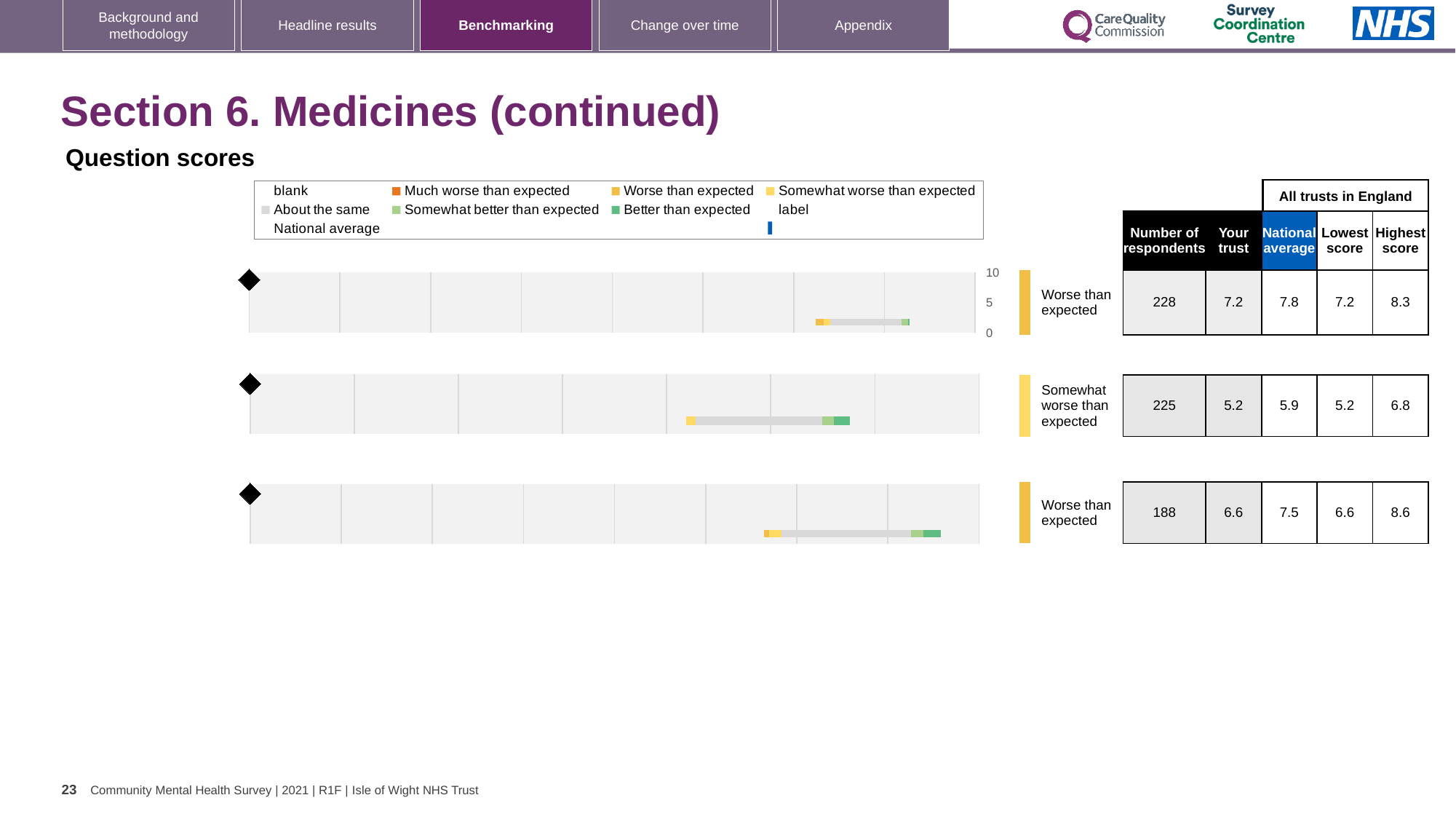
In the middle chart, how many respondents are there? 225 In the bottom chart, which is larger: the 'Your trust' score or the national average? National average How many question charts are shown on the slide? 3 In the top chart, what is the 'Your trust' score? 7.2 What benchmark rating is shown for the bottom chart? Worse than expected In the middle chart, what is the lowest score among all trusts in England? 5.2 In the top chart, what is the difference between the national average and the 'Your trust' score? 0.6 What benchmark rating is shown for the middle chart? Somewhat worse than expected Which chart has the lowest 'Your trust' score? Middle chart (5.2) In the top chart, what is the national average score? 7.8 In the bottom chart, what is the highest score among all trusts in England? 8.6 Which chart has the largest number of respondents? Top chart (228)